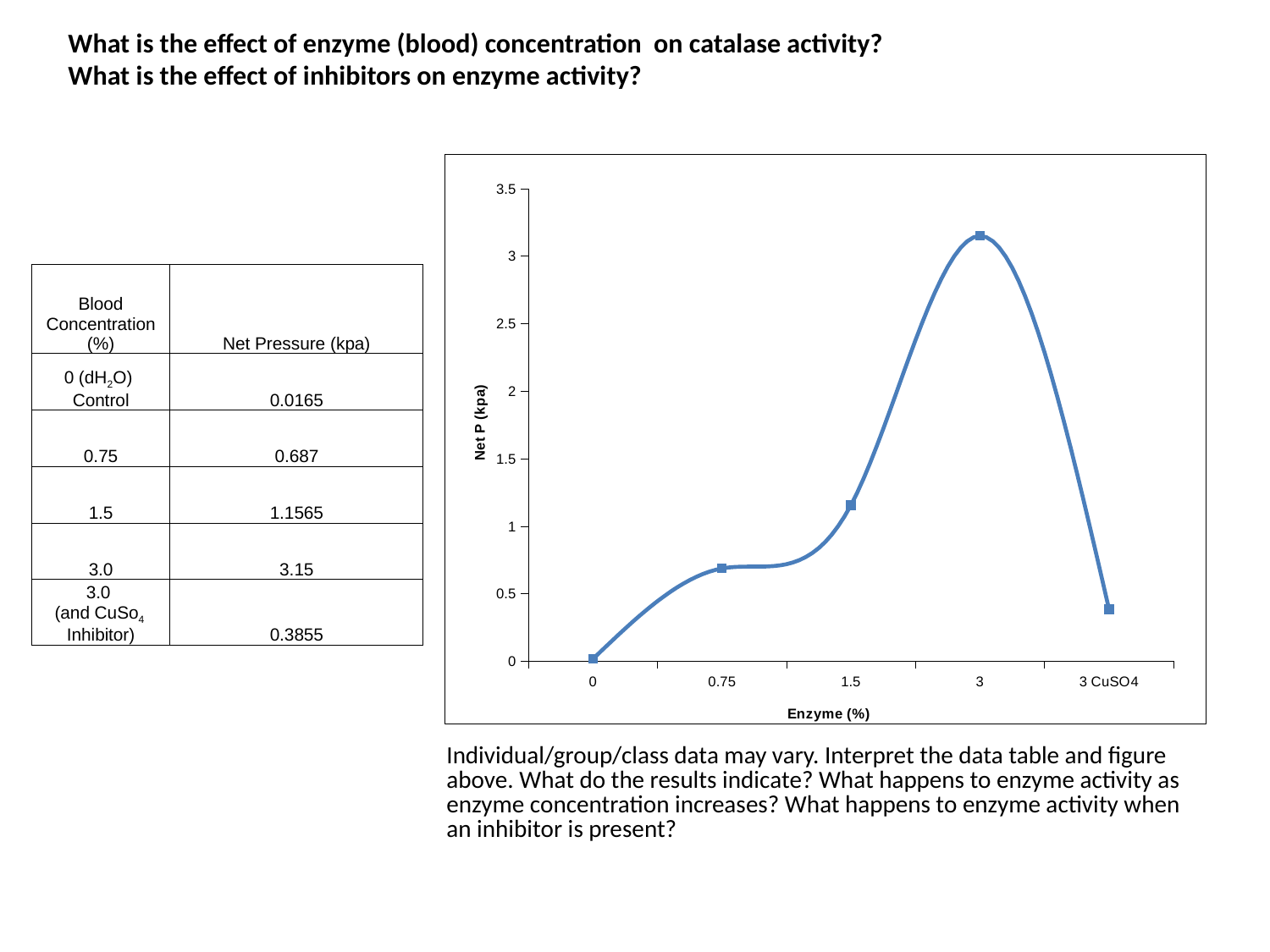
At which enzyme concentration on the x axis is the net pressure highest? 3 How many data points are plotted on the chart? 5 At which enzyme concentration on the x axis is the net pressure lowest? 0 Using the table values, what is the difference in net pressure between 3.0 blood concentration and 3.0 with CuSO4 inhibitor? 2.7645 What type of chart is shown on the slide? line chart According to the data table, what is the net pressure (kpa) at a blood concentration of 3.0? 3.15 Is the value for enzyme concentration 3 greater or less than 2.5? greater Is the value for enzyme concentration 1.5 greater or less than 1.5? less Is the value for 3 CuSO4 greater or less than 0.5? less Which has the larger net pressure: enzyme concentration 1.5 or 3 CuSO4? 1.5 According to the data table, what is the net pressure (kpa) at a blood concentration of 0.75? 0.687 What is the label on the y axis of the chart? Net P (kpa)